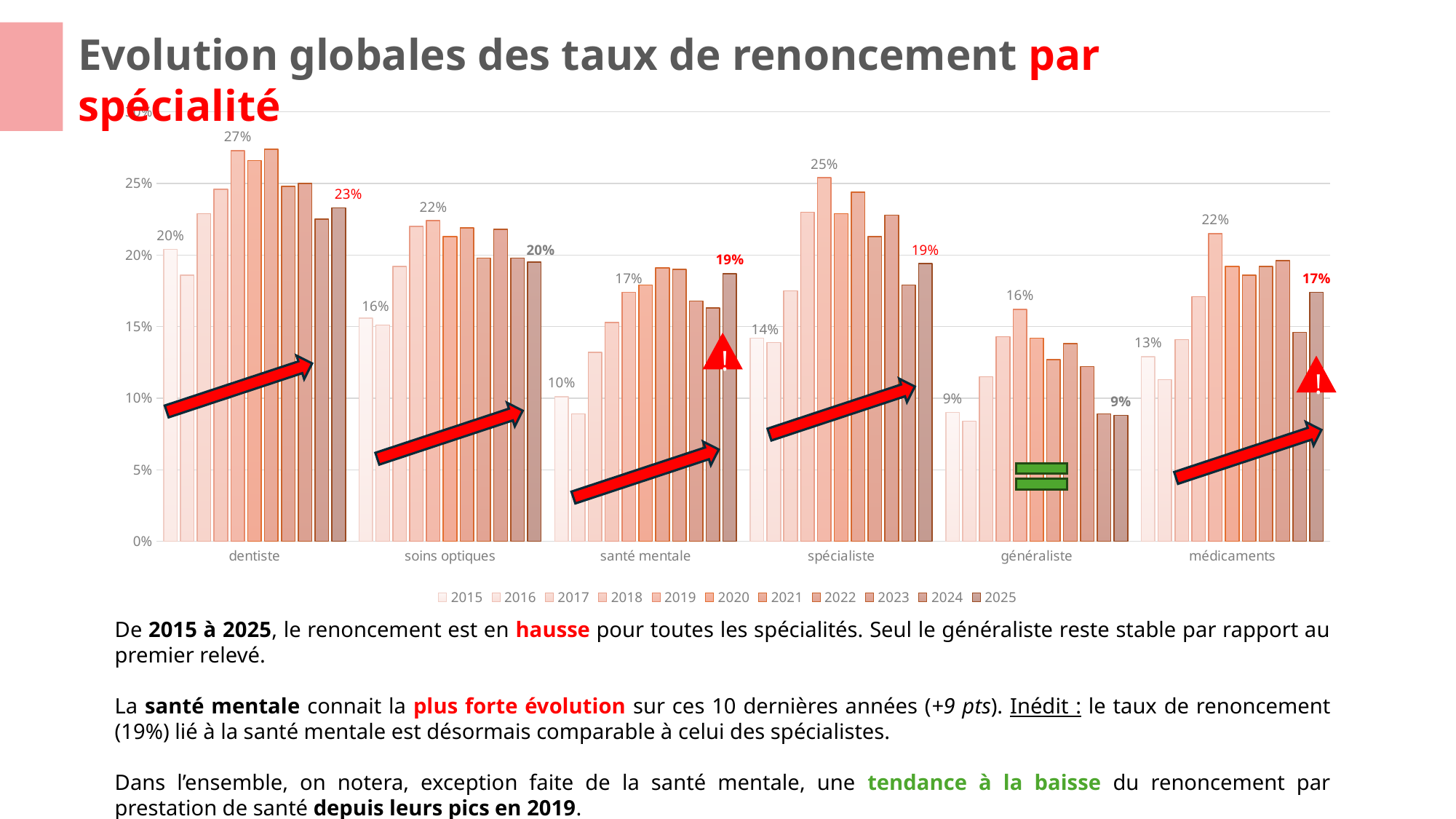
Which category has the lowest 2025 value? généraliste What is the renunciation rate for dentiste in 2015? 20% Which has the higher 2025 value, dentiste or médicaments? dentiste What is the value for santé mentale in 2025? 19% What is the value for généraliste in 2025? 9% Which category has the highest 2025 value? dentiste By how many percentage points did the santé mentale rate change from 2015 to 2025? 9 points How many categories (specialties) are shown on the x axis? 6 What is the difference between the dentiste rate in 2025 and in 2015? 3 points Is the value for dentiste in 2016 greater or less than 15%? greater What is the highest value labeled for spécialiste? 25% How many series does the legend list? 11